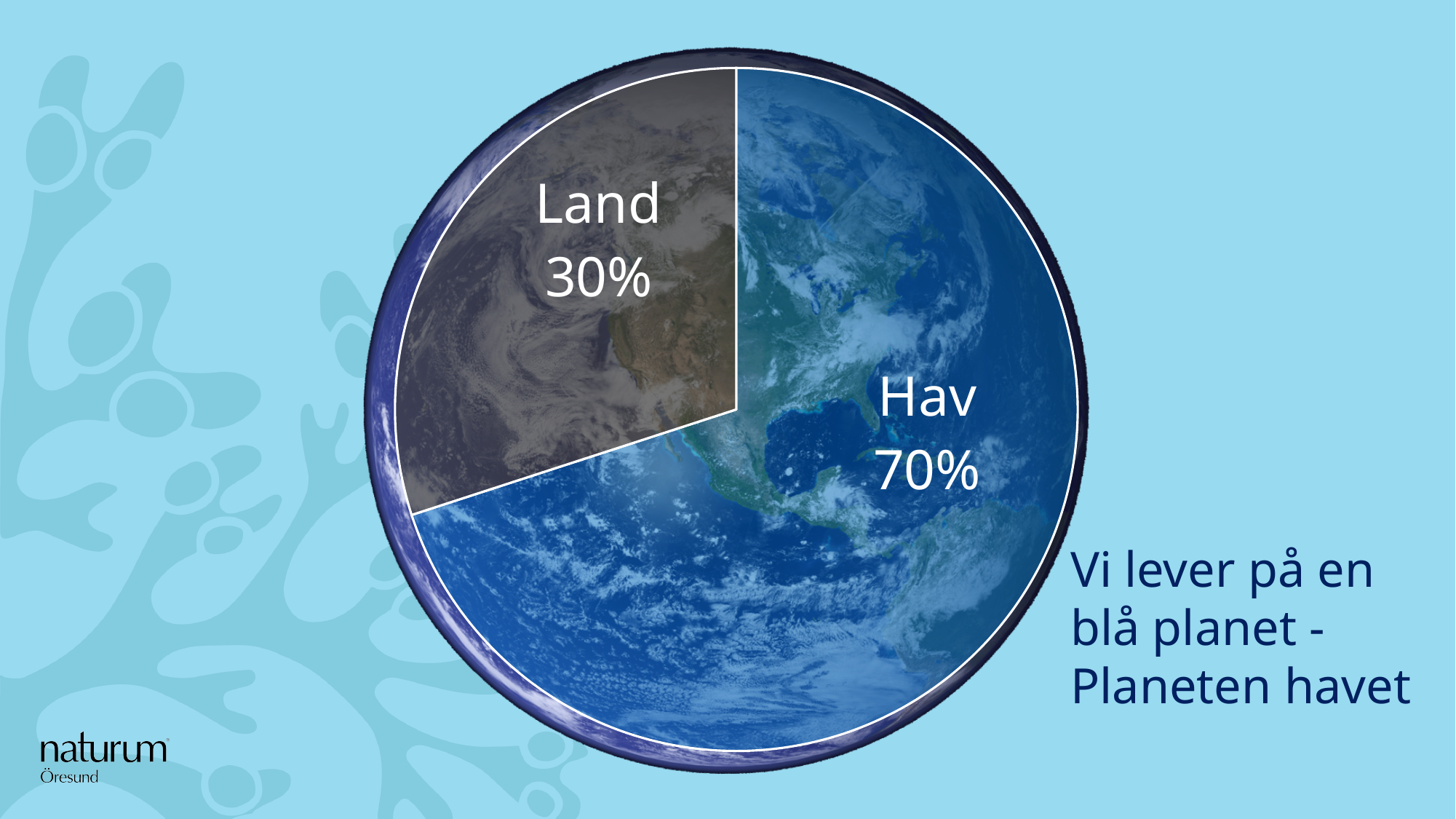
What is the difference in percentage points between the Hav slice and the Land slice? 40 What kind of chart is shown on the slide? pie chart Is the value for Hav greater or less than 50%? greater What image is used as the background of the pie chart? the Earth Which is larger, the Hav slice or the Land slice? Hav Which slice of the pie is the smallest? Land What share of the pie does Hav represent? 70% How many slices does the pie chart have? 2 Is the value for Land greater or less than 50%? less What text appears to the right of the pie chart? Vi lever på en blå planet - Planeten havet What share of the pie does Land represent? 30% Which slice of the pie is the largest? Hav